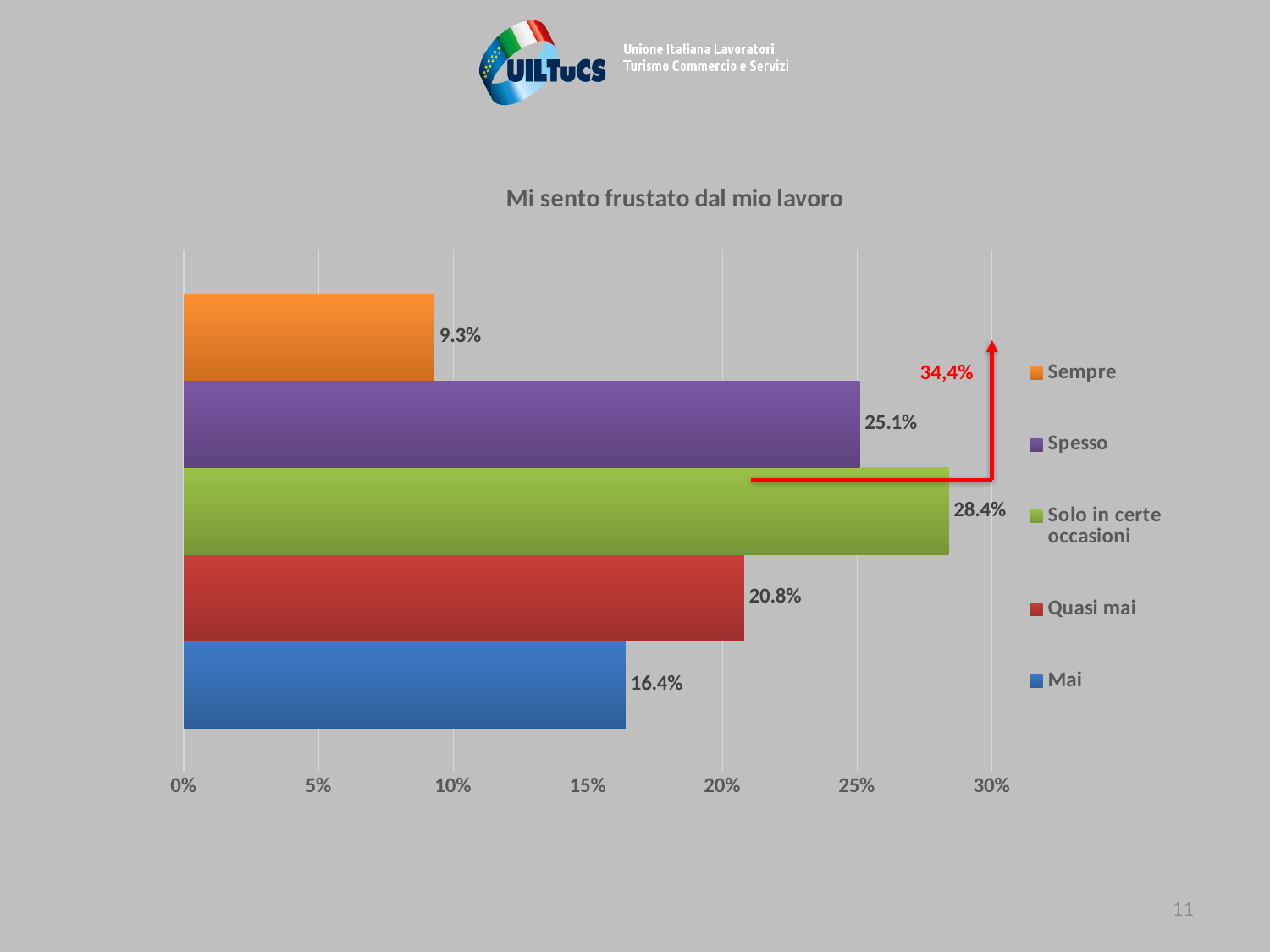
Which category has the highest value? Solo in certe occasioni What is the title of the chart? Mi sento frustato dal mio lavoro What is the difference between the values for Solo in certe occasioni and Spesso? 3.3% What kind of chart is shown on the slide? Bar chart What is the value for Sempre? 9.3% What is the value for Quasi mai? 20.8% What is the value for Mai? 16.4% How many categories are shown in the chart? 5 Which is larger, the value for Quasi mai or the value for Mai? Quasi mai What is the value for Solo in certe occasioni? 28.4% Which category has the lowest value? Sempre What is the value for Spesso? 25.1%